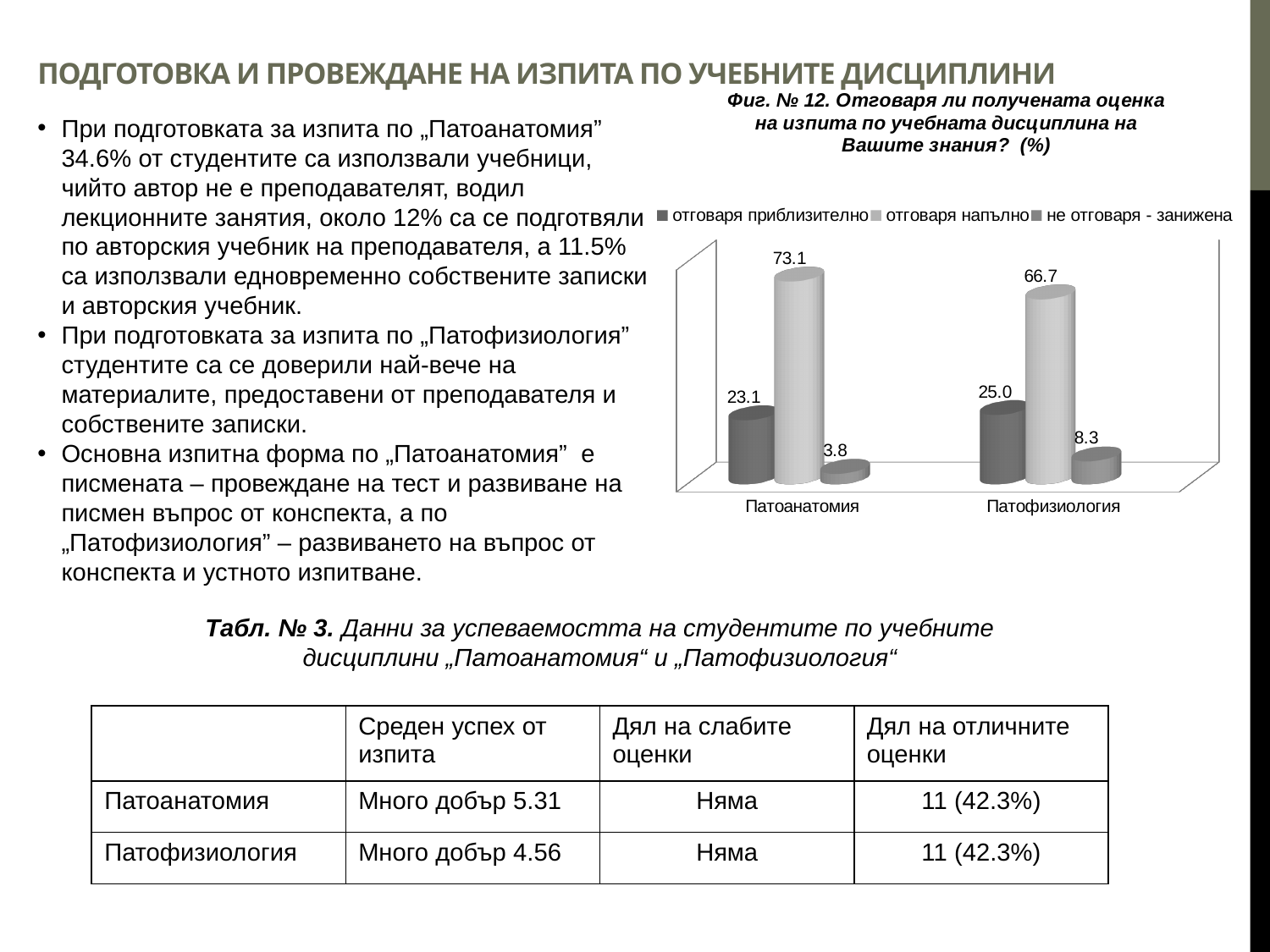
Which category has the larger value for "не отговаря - занижена", Патоанатомия or Патофизиология? Патофизиология What is the value for "отговаря приблизително" for Патофизиология? 25.0 What type of chart is shown in Фиг. № 12? bar chart What is the value for "не отговаря - занижена" for Патоанатомия? 3.8 What is the title of the chart? Фиг. № 12. Отговаря ли получената оценка на изпита по учебната дисциплина на Вашите знания? (%) How many series does the legend of the chart list? 3 Which series has the highest value for Патоанатомия? отговаря напълно What is the value for "отговаря напълно" for Патофизиология? 66.7 Which series has the lowest value for Патофизиология? не отговаря - занижена What is the value for "отговаря напълно" for Патоанатомия? 73.1 How many categories are shown on the x axis of the chart? 2 What is the difference between the "отговаря напълно" values for Патоанатомия and Патофизиология? 6.4